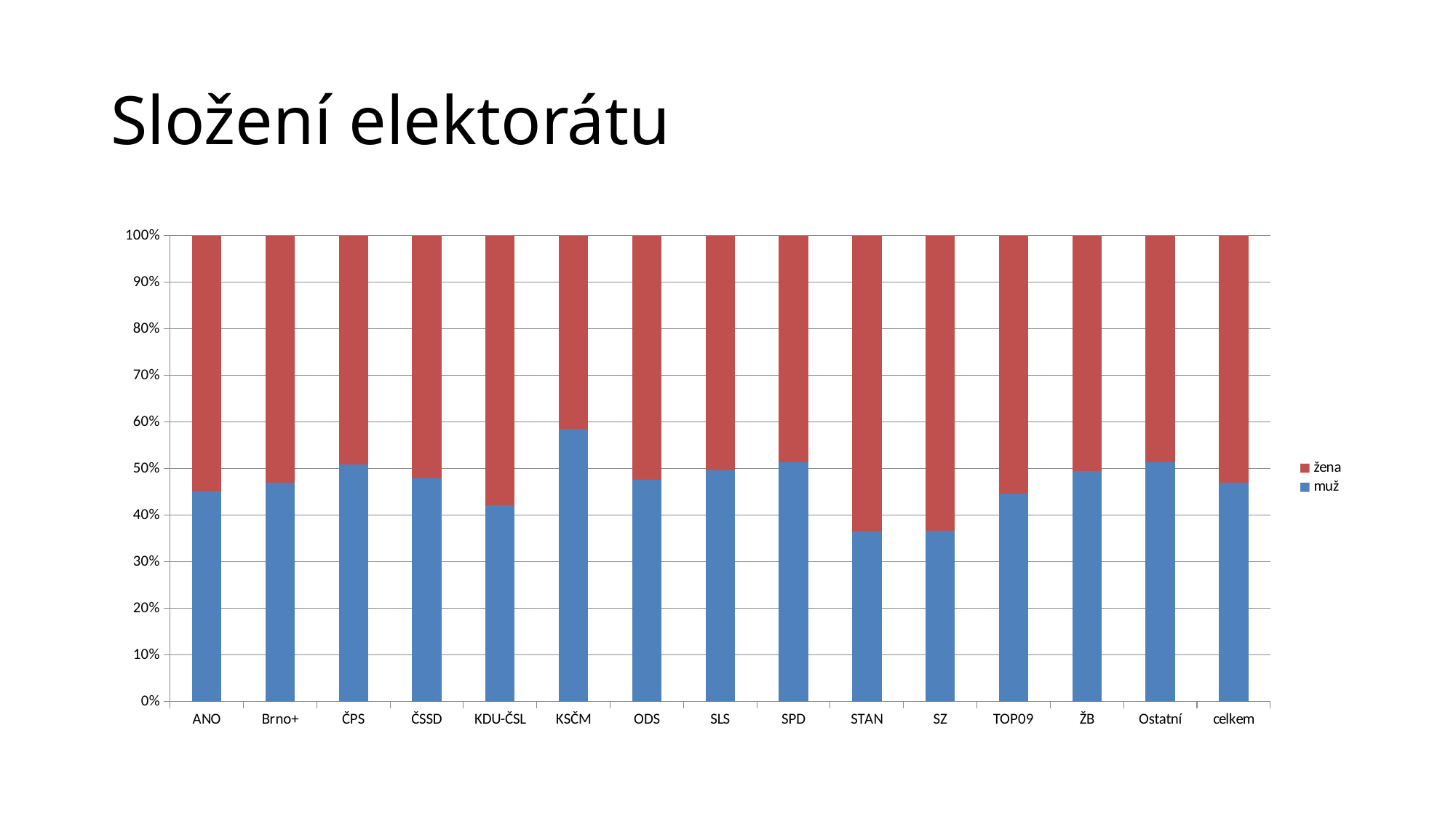
Which has a larger muž share, KSČM or ANO? KSČM How many series does the chart's legend list? 2 Which has a larger žena share, STAN or KSČM? STAN What kind of chart is shown on the slide? bar chart Is the muž share for STAN greater or less than 40%? less How many categories are shown along the x axis of the chart? 15 Is the muž share for KSČM greater or less than 50%? greater What is the title of the slide containing the chart? Složení elektorátu Which category has the highest share for the muž series? KSČM Is the muž share for KDU-ČSL greater or less than 40%? greater Which colour represents the žena series in the chart? red